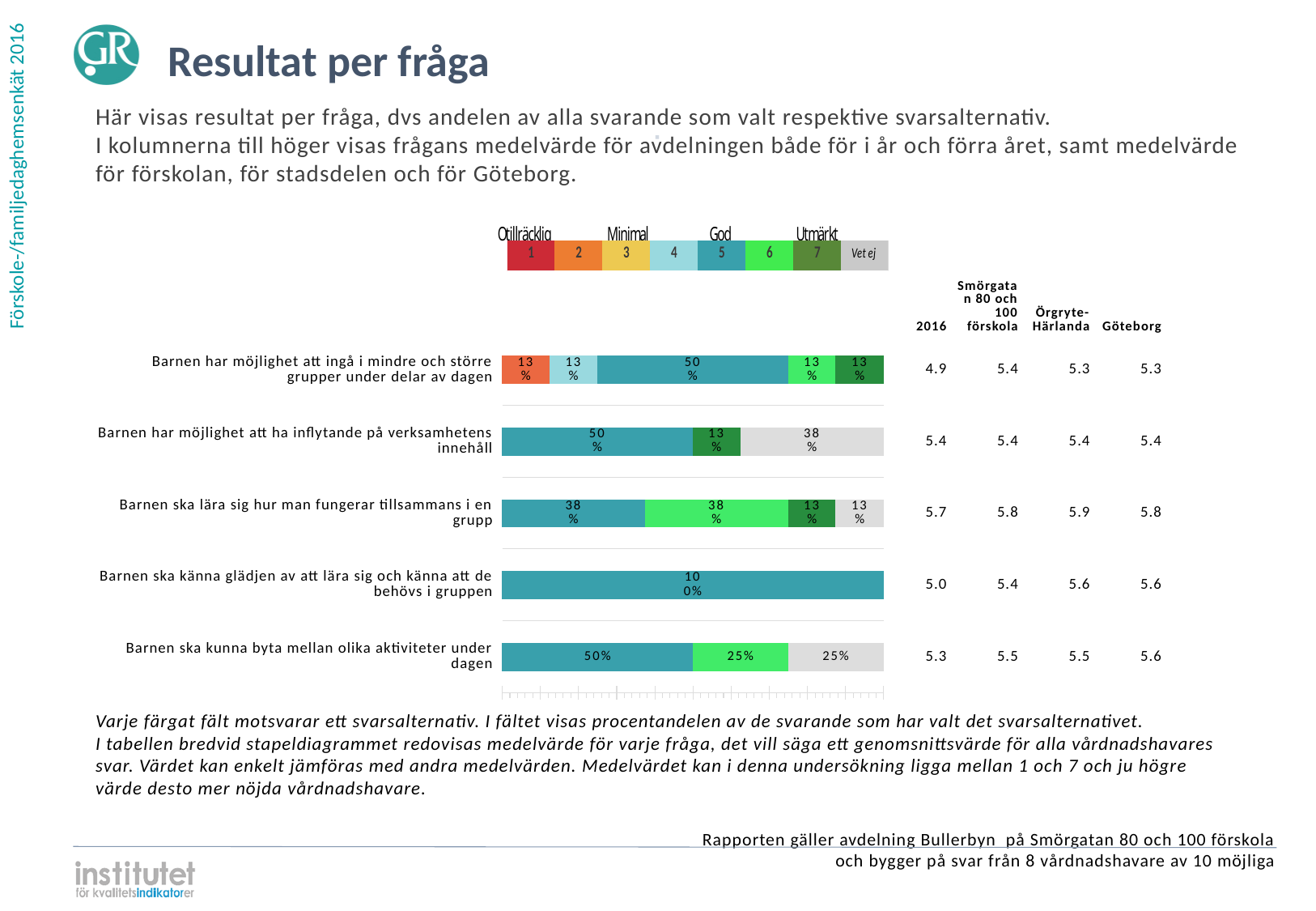
What percentage of respondents chose answer 5 for 'Barnen ska känna glädjen av att lära sig och känna att de behövs i gruppen'? 100% For 'Barnen ska lära sig hur man fungerar tillsammans i en grupp', what is the difference between the share choosing answer 5 and the share choosing answer 7? 25% Which colour in the legend represents answer alternative 1 (Otillräcklig)? Red What kind of chart is used to show the results per question? Stacked bar chart What percentage of respondents answered 'Vet ej' for 'Barnen har möjlighet att ha inflytande på verksamhetens innehåll'? 38% Which question has the highest 2016 mean value in the table next to the chart? Barnen ska lära sig hur man fungerar tillsammans i en grupp Which question has the lowest 2016 mean value in the table next to the chart? Barnen har möjlighet att ingå i mindre och större grupper under delar av dagen How many questions (categories) are shown in the bar chart? 5 What percentage of respondents chose answer 6 for 'Barnen ska kunna byta mellan olika aktiviteter under dagen'? 25% How many answer alternatives does the legend above the chart list? 8 What percentage of respondents chose answer 5 (God) for 'Barnen har möjlighet att ingå i mindre och större grupper under delar av dagen'? 50% What is the 2016 mean value for 'Barnen ska kunna byta mellan olika aktiviteter under dagen'? 5.3